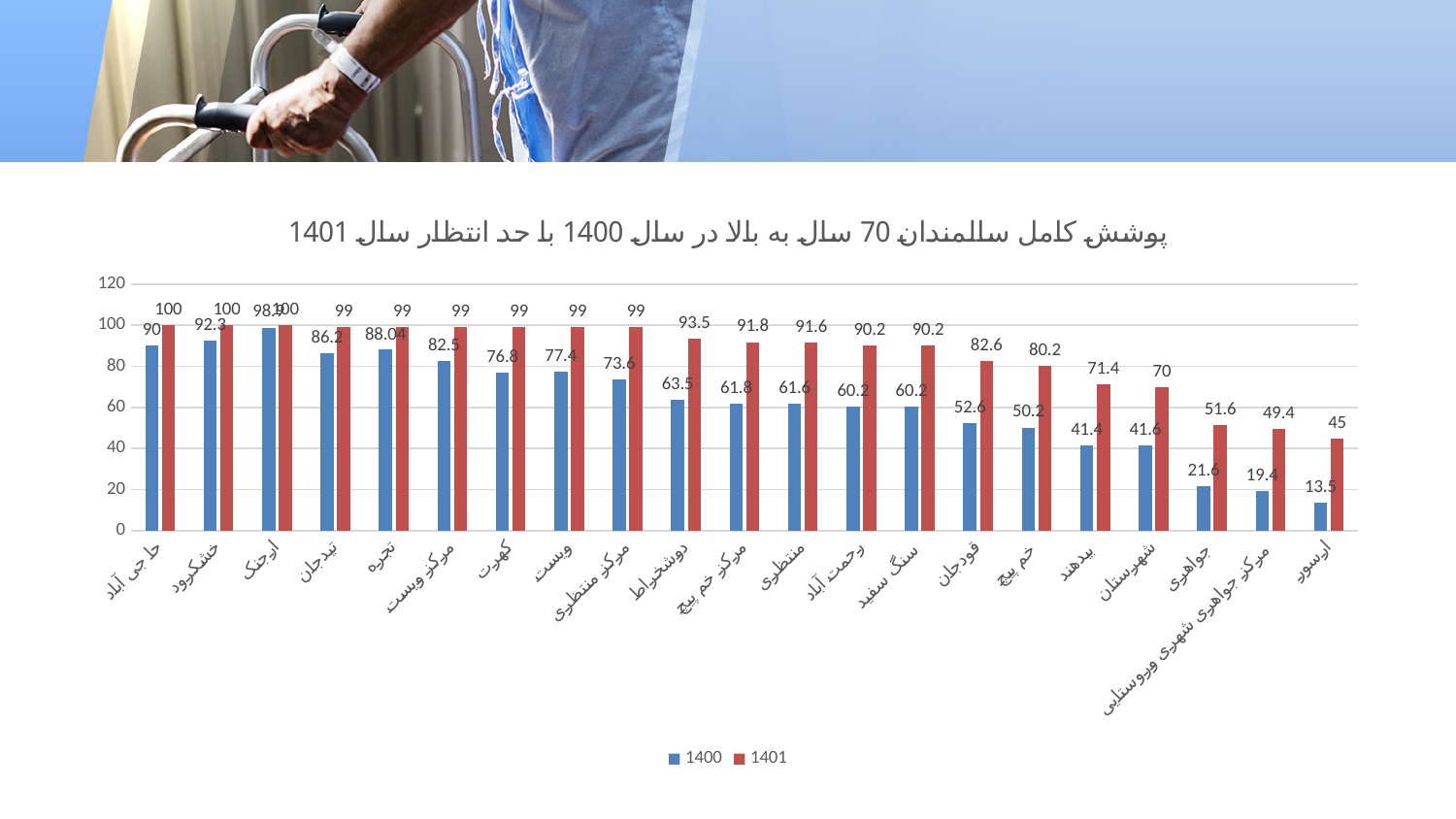
Do the 1401 values generally rise or fall from left to right along the x axis? fall What type of chart is shown on the slide? bar chart Which series is shown in red in the legend? 1401 What is the difference between the 1401 and 1400 values for قودجان? 30 What is the 1400 value for اریسور? 13.5 How many series does the legend list? 2 What is the 1400 value for نجره? 88.04 How many categories are shown on the x axis? 21 What is the 1401 value for دوشخراط? 93.5 Which category has the highest 1400 value? ارجنک Which is larger, the 1400 value for بیدهند or the 1400 value for شهرستان? شهرستان Which category has the lowest 1400 value? ارسور